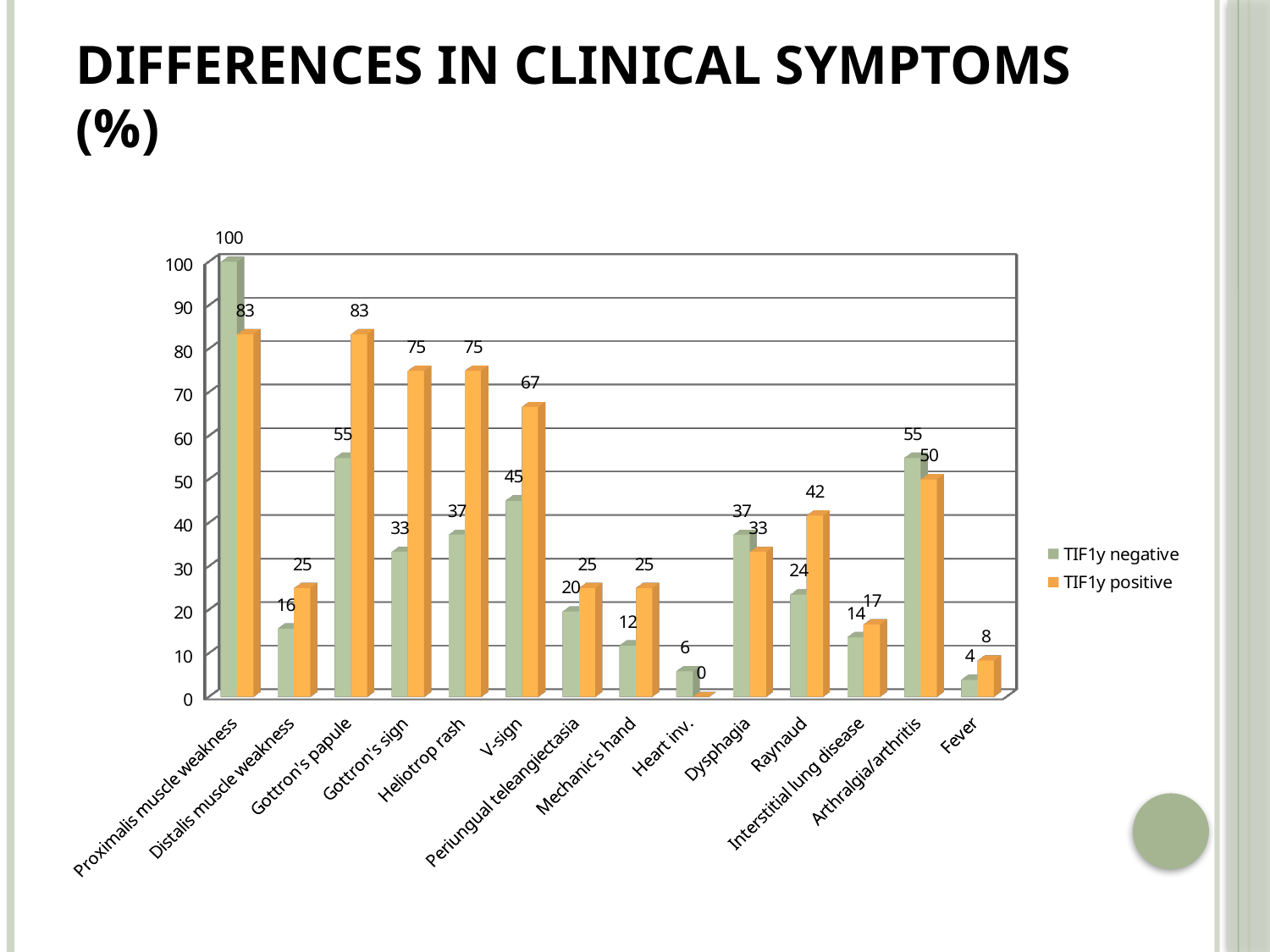
How many symptom categories are shown on the x axis? 14 What kind of chart is shown on the slide? Bar chart What is the difference between the TIF1y positive and TIF1y negative values for Gottron's papule? 28 Is the TIF1y positive value for V-sign greater or less than 60? greater What is the title of the slide? Differences in clinical symptoms (%) What is the TIF1y positive value for Gottron's sign? 75 Which is larger for Raynaud: the TIF1y negative value or the TIF1y positive value? TIF1y positive Which category has the lowest TIF1y positive value? Heart inv. What is the TIF1y negative value for Dysphagia? 37 Which category has the highest TIF1y negative value? Proximalis muscle weakness How many series does the legend list? 2 What is the TIF1y positive value for Heart inv.? 0